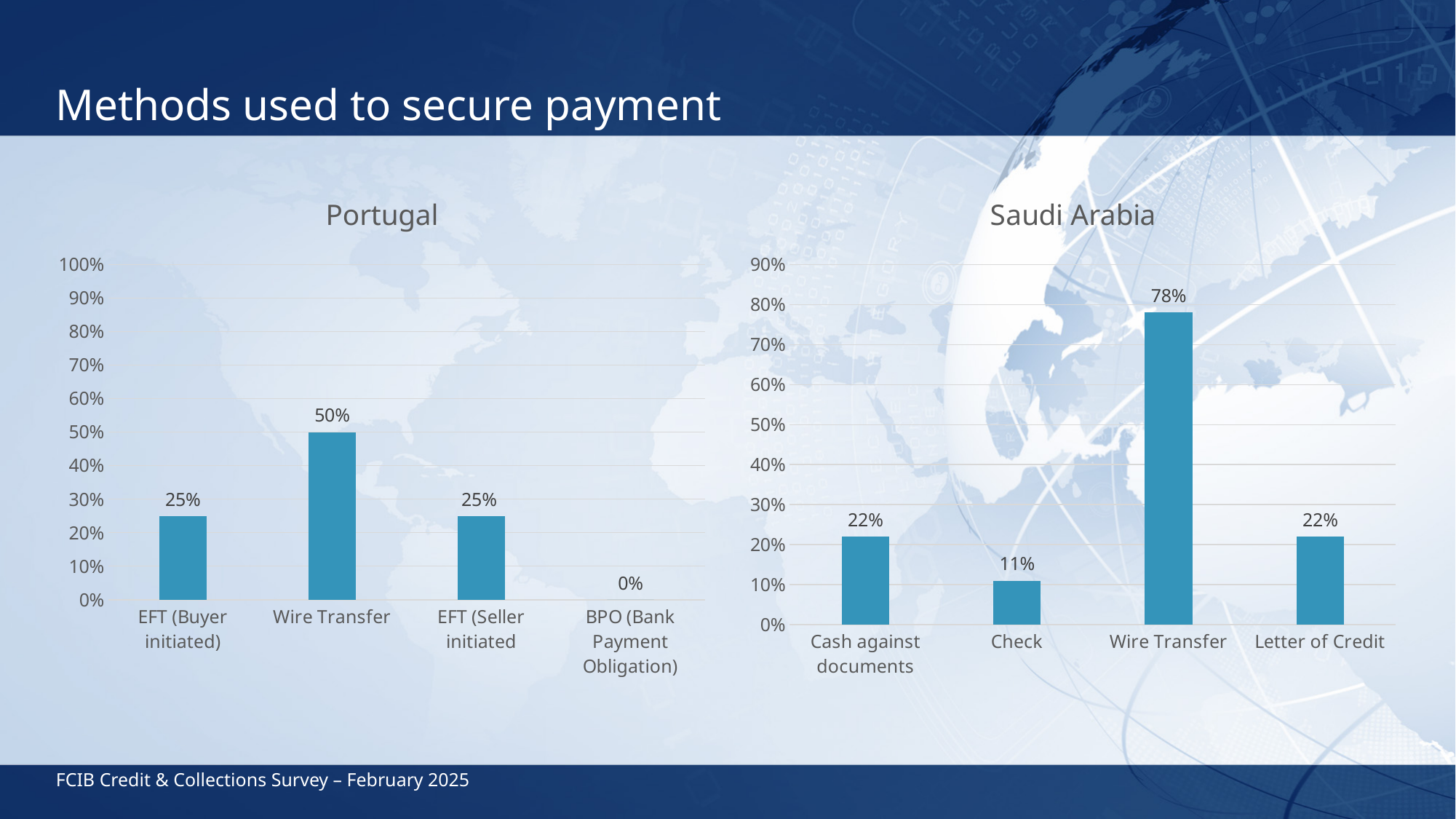
What is the title of the chart on the right side of the slide? Saudi Arabia In the Saudi Arabia chart, what is the value for Letter of Credit? 22% In the Portugal chart, which method has the lowest value? BPO (Bank Payment Obligation) Which is larger: Wire Transfer in the Portugal chart or Wire Transfer in the Saudi Arabia chart? Wire Transfer in the Saudi Arabia chart In the Saudi Arabia chart, what is the value for Check? 11% In the Portugal chart, what is the difference between Wire Transfer and EFT (Buyer initiated)? 25% In the Portugal chart, what is the value for Wire Transfer? 50% In the Saudi Arabia chart, which method has the lowest value? Check What kind of chart is the Portugal chart? Bar chart In the Saudi Arabia chart, what is the difference between Wire Transfer and Cash against documents? 56% How many categories are shown in the Saudi Arabia chart? 4 In the Portugal chart, which method has the highest value? Wire Transfer